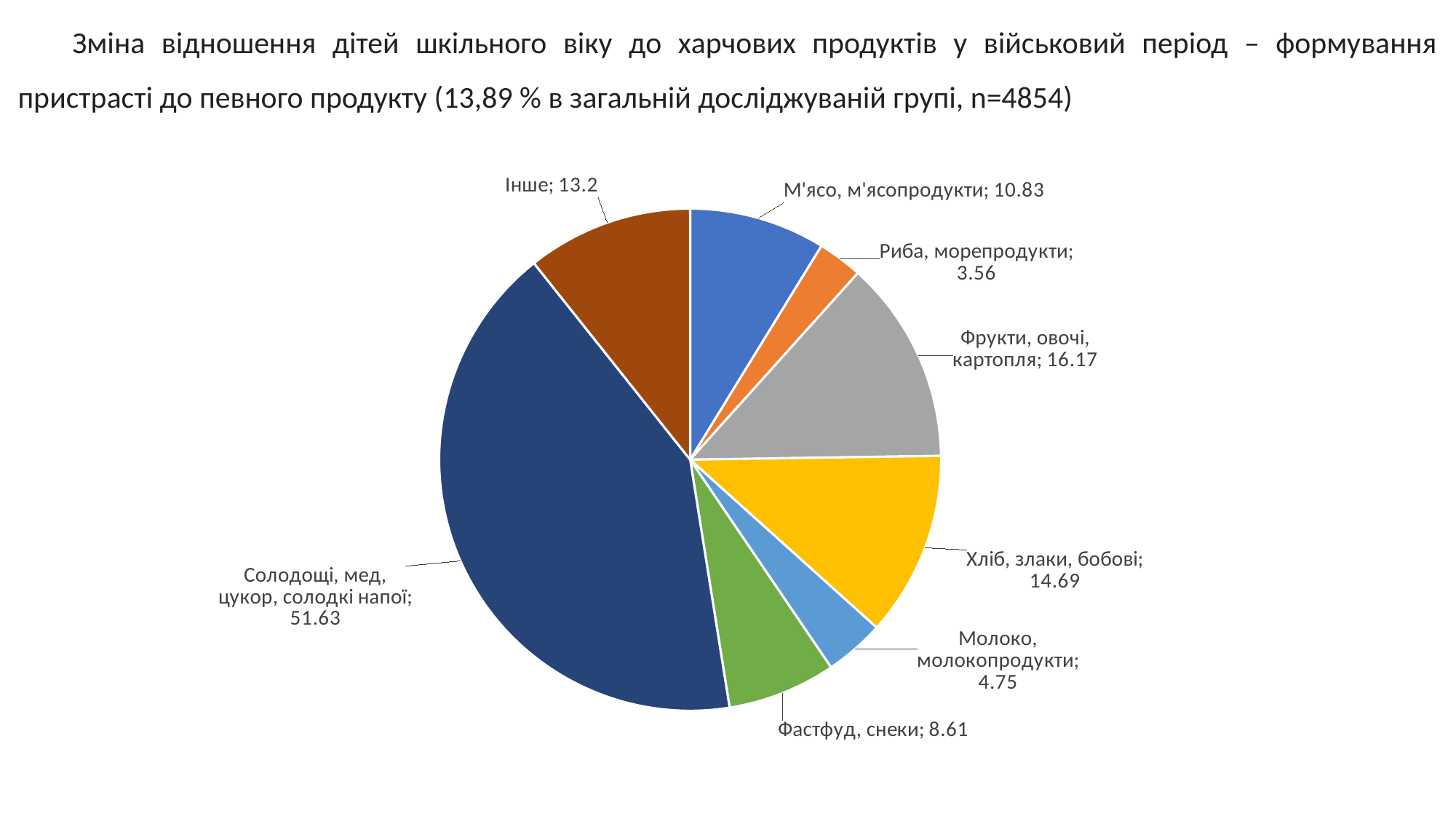
What is the difference between the values for Фрукти, овочі, картопля and Хліб, злаки, бобові? 1.48 What is the value for Фрукти, овочі, картопля? 16.17 Which category has the smallest slice? Риба, морепродукти What is the value for Фастфуд, снеки? 8.61 Which category has the largest slice? Солодощі, мед, цукор, солодкі напої What is the difference between the values for Молоко, молокопродукти and Риба, морепродукти? 1.19 What is the value for Риба, морепродукти? 3.56 What is the value for Солодощі, мед, цукор, солодкі напої? 51.63 What type of chart is shown on the slide? pie chart How many slices does the pie chart have? 8 What colour is the slice for Хліб, злаки, бобові? yellow Which is larger: the value for М'ясо, м'ясопродукти or the value for Інше? Інше